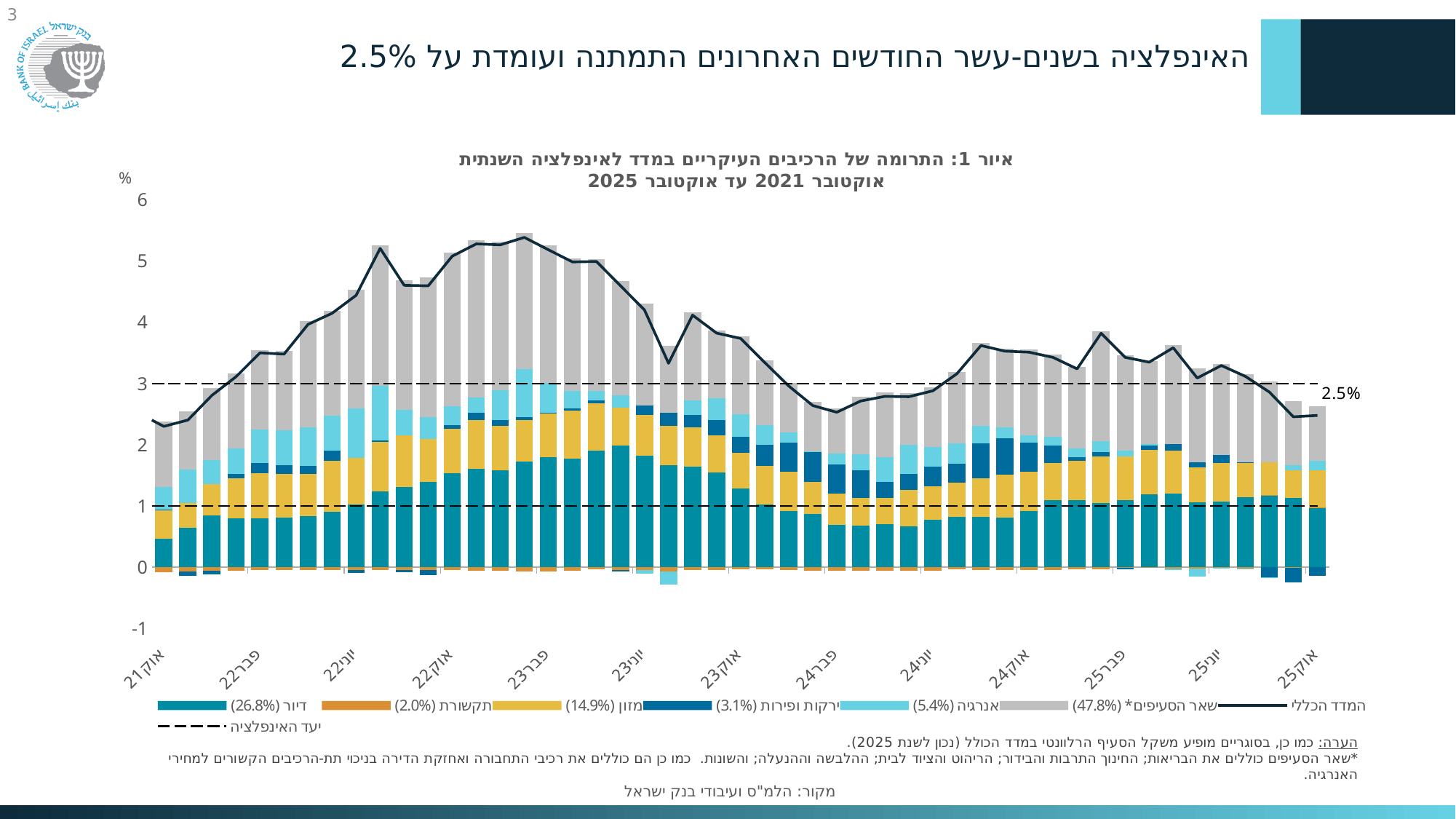
What weight does the legend give to the other items (שאר הסעיפים) component? 47.8% What weight does the legend give to the housing (דיור) component? 26.8% What kind of chart is shown on the slide? stacked bar chart with a line Which is larger, the overall index (המדד הכללי) at יוני 22 or at יוני 25? יוני 22 Is the overall index (המדד הכללי) at פבר' 24 greater or less than 3? less How many entries does the chart legend list? 8 Between פבר' 23 and פבר' 24, does the overall index (המדד הכללי) rise or fall? fall At which labelled month does the overall index (המדד הכללי) line reach its highest point? פבר' 23 Is the overall index (המדד הכללי) at אוק' 21 greater or less than 3? less Is the overall index (המדד הכללי) at פבר' 23 greater or less than 5? greater How many month labels are shown on the x axis? 13 What is the value of the overall index (המדד הכללי) line at אוק' 25, as labelled on the chart? 2.5%